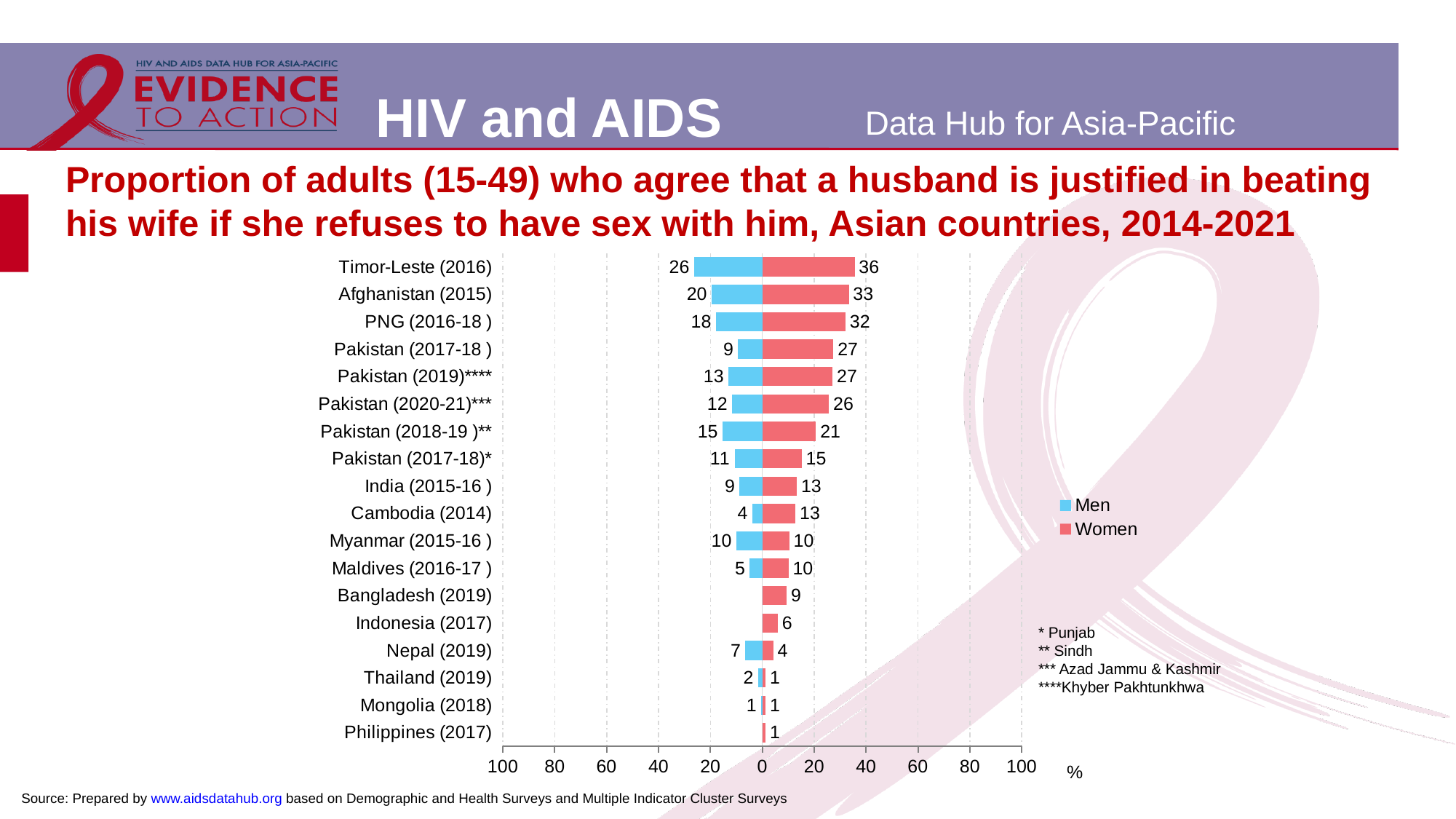
What is the value for Women in Cambodia (2014)? 13 What is the value for Men in Afghanistan (2015)? 20 What is the value for Women in Timor-Leste (2016)? 36 What is the difference between the Women and Men values for Afghanistan (2015)? 13 Which country has the highest value for Women? Timor-Leste (2016) For Nepal (2019), which is larger, the value for Men or the value for Women? Men What type of chart is shown on the slide? bar chart What is the difference between the Women and Men values for Timor-Leste (2016)? 10 How many series does the legend list? 2 What are the two series shown in the legend? Men and Women Which country has the highest value for Men? Timor-Leste (2016) How many countries/surveys are listed on the chart? 18